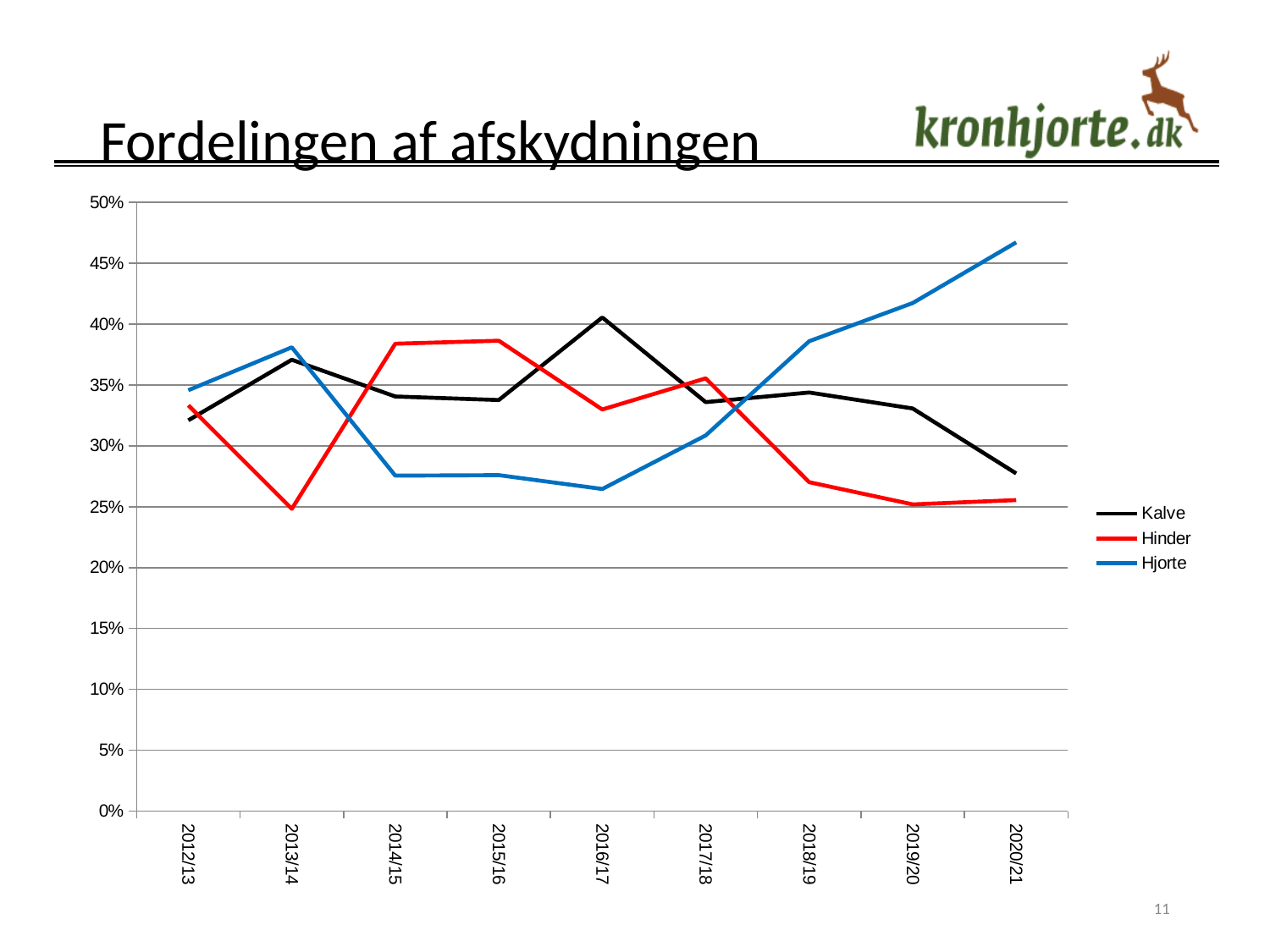
In 2018/19, which is larger: the value for Kalve or the value for Hinder? Kalve Does the Hjorte line rise or fall from 2016/17 to 2020/21? Rises What kind of chart is shown on the slide? Line chart Is the value for Kalve in 2016/17 greater or less than 35%? greater Which series has the lowest value in 2013/14? Hinder What colour is the Hinder line in the legend? Red Is the value for Hjorte in 2020/21 greater or less than 45%? greater How many seasons are plotted along the x axis? 9 In which season does the Kalve series reach its lowest value? 2020/21 Which series has the highest value in 2020/21? Hjorte How many series does the legend list? 3 Is the value for Hinder in 2013/14 greater or less than 30%? less